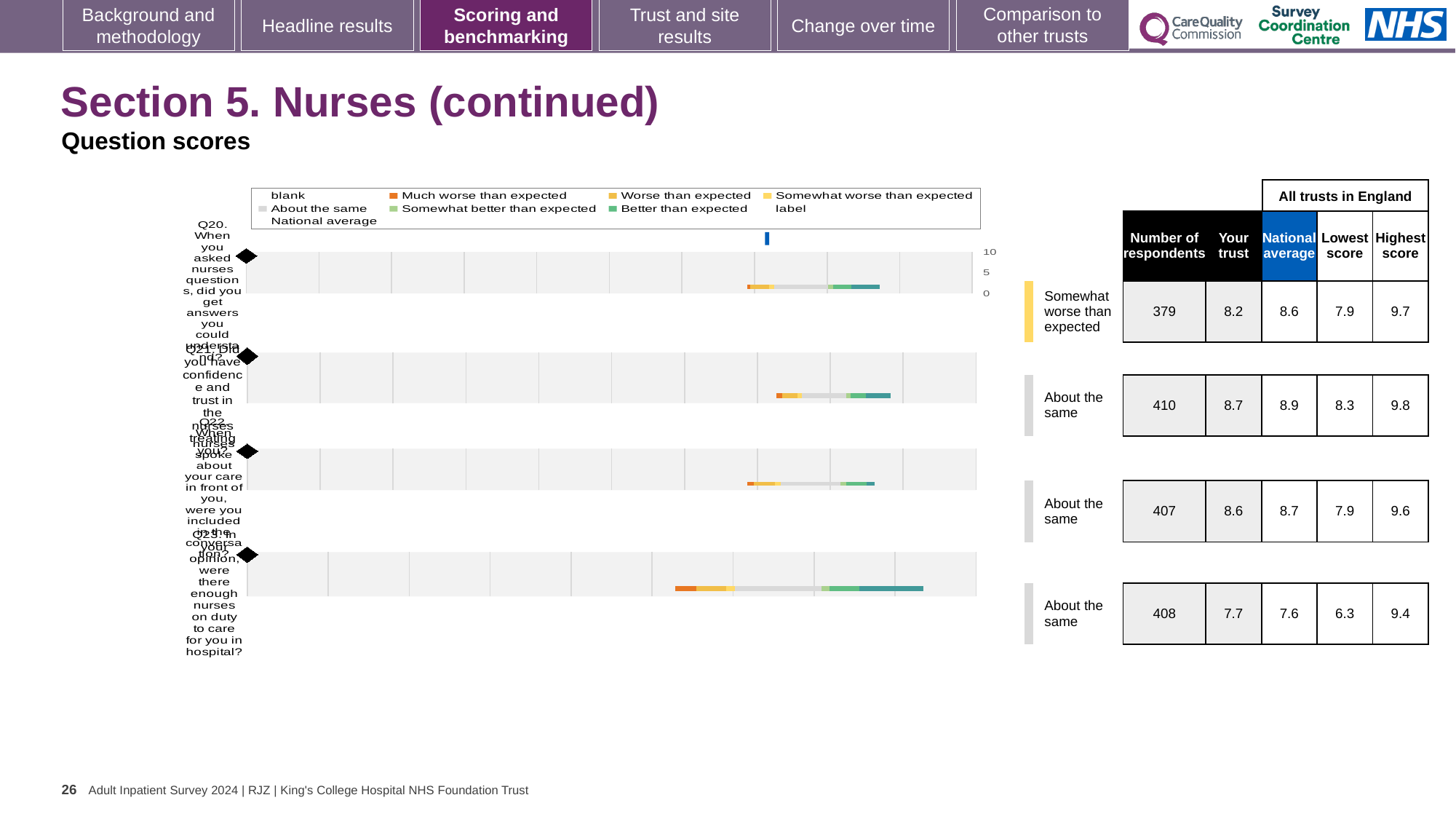
Which question has the highest 'Your trust' score? Q21 How many respondents answered Q22? 407 For Q23, which is larger: the 'Your trust' score or the national average? Your trust What kind of chart is shown on the slide? bar chart How many questions (rows) are plotted in the chart? 4 What is the difference between the national average and the 'Your trust' score for Q20? 0.4 What is the national average score for Q21 (Did you have confidence and trust in the nurses treating you)? 8.9 Which benchmark category is shown for Q20? Somewhat worse than expected What is the 'Your trust' score for Q20 (When you asked nurses questions, did you get answers you could understand)? 8.2 What is the highest score across all trusts in England for Q21? 9.8 Which question has the lowest 'Your trust' score? Q23 What is the lowest score across all trusts in England for Q23 (were there enough nurses on duty)? 6.3